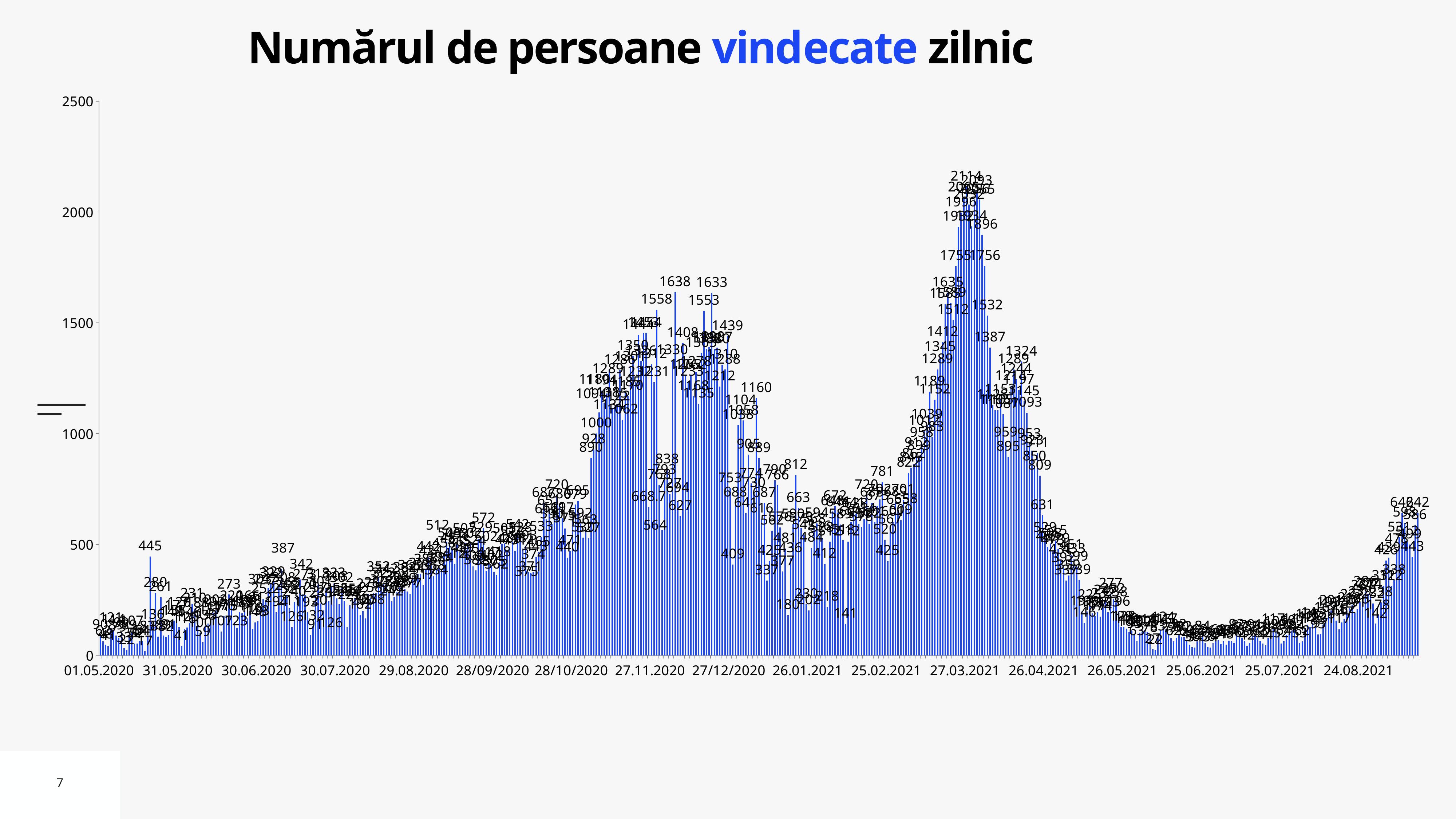
Do the values rise or fall from 25.07.2021 to the end of the chart? rise What is the difference between the peak of the March 2021 wave (2114) and the peak of the November 2020 wave (1638)? 476 What is the title of the chart? Numărul de persoane vindecate zilnic What is the maximum value shown on the vertical axis? 2500 Which wave has the higher peak: the one around 27.11.2020 or the one around 27.03.2021? the one around 27.03.2021 What kind of chart is shown on the slide? bar chart What is the highest value labeled on the chart? 2114 Is the highest value on the chart greater or less than 2000? greater What is the value of the tallest bar in the November 2020 wave (near the 27.11.2020 tick)? 1638 Are the values around 25.06.2021 greater or less than 500? less What is the value of the tallest bar in May 2020 (near the 31.05.2020 tick)? 445 Do the values rise or fall between 26.04.2021 and 25.06.2021? fall